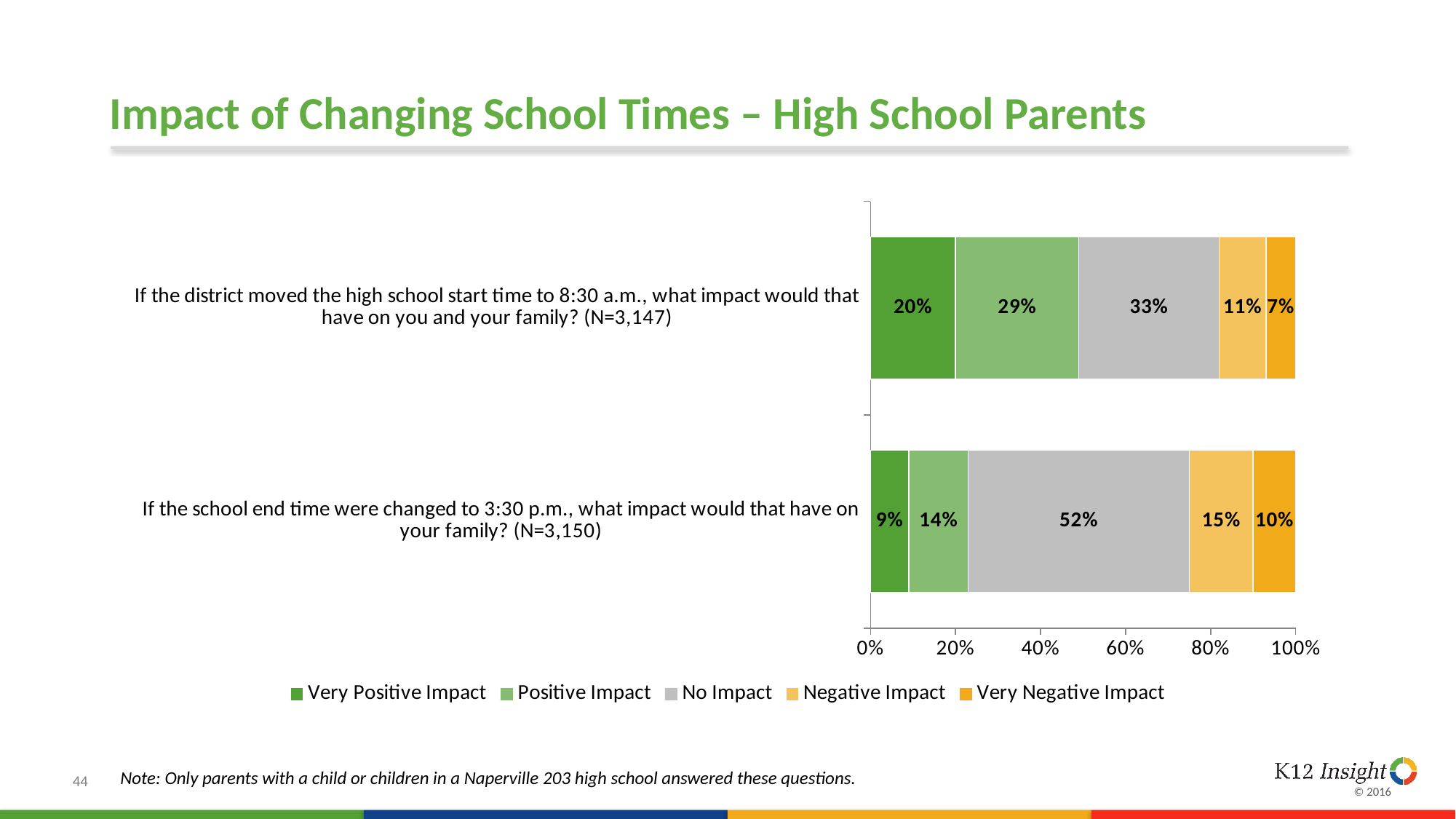
What percentage of high school parents said changing the end time to 3:30 p.m. would have a Very Negative Impact? 10% What percentage of high school parents said moving the start time to 8:30 a.m. would have a Very Positive Impact? 20% Which response category has the smallest share for the 3:30 p.m. end time question? Very Positive Impact What is the difference between the No Impact share for the 3:30 p.m. end time question and the No Impact share for the 8:30 a.m. start time question? 19 percentage points What percentage of high school parents said moving the start time to 8:30 a.m. would have a Negative Impact? 11% How many series does the legend list? 5 What is the combined share of Very Positive Impact and Positive Impact for the 8:30 a.m. start time question? 49% Which question has a larger Positive Impact share: the 8:30 a.m. start time or the 3:30 p.m. end time? The 8:30 a.m. start time What kind of chart is shown on the slide? Stacked bar chart Which response category has the largest share for the 8:30 a.m. start time question? No Impact What is the sample size (N) for the 3:30 p.m. end time question? 3,150 What percentage of high school parents said changing the end time to 3:30 p.m. would have No Impact? 52%